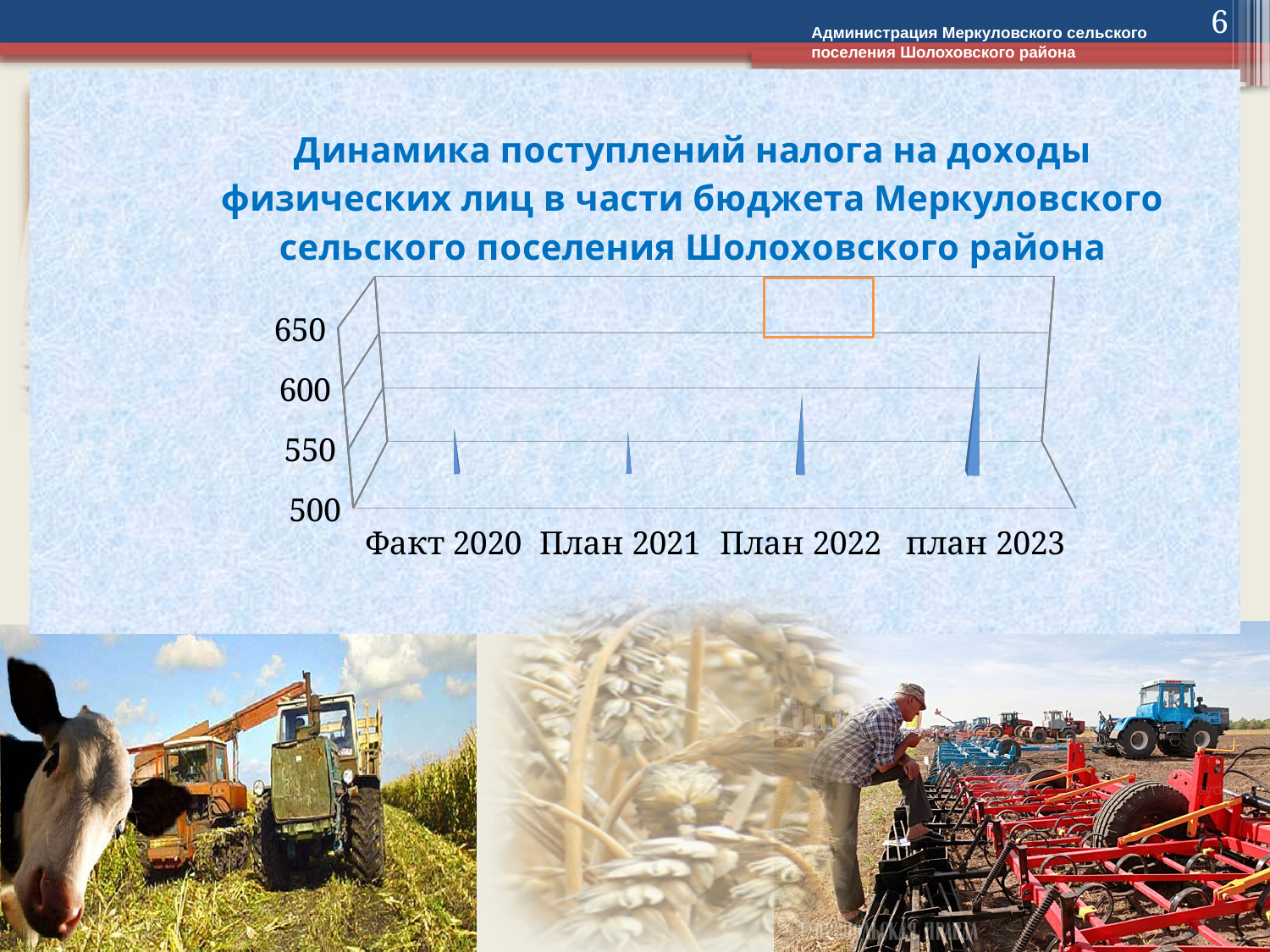
Which is larger, the value for план 2023 or the value for Факт 2020? план 2023 Do the values rise or fall from Факт 2020 to план 2023? rise Is the value for План 2022 greater or less than 550? greater Is the value for план 2023 greater or less than 600? greater Which category has the highest value in the chart? план 2023 What is the highest tick value shown on the vertical axis? 650 How many categories are shown on the x axis of the chart? 4 Is the value for Факт 2020 greater or less than 600? less Which is larger, the value for План 2022 or the value for План 2021? План 2022 What is the lowest tick value shown on the vertical axis? 500